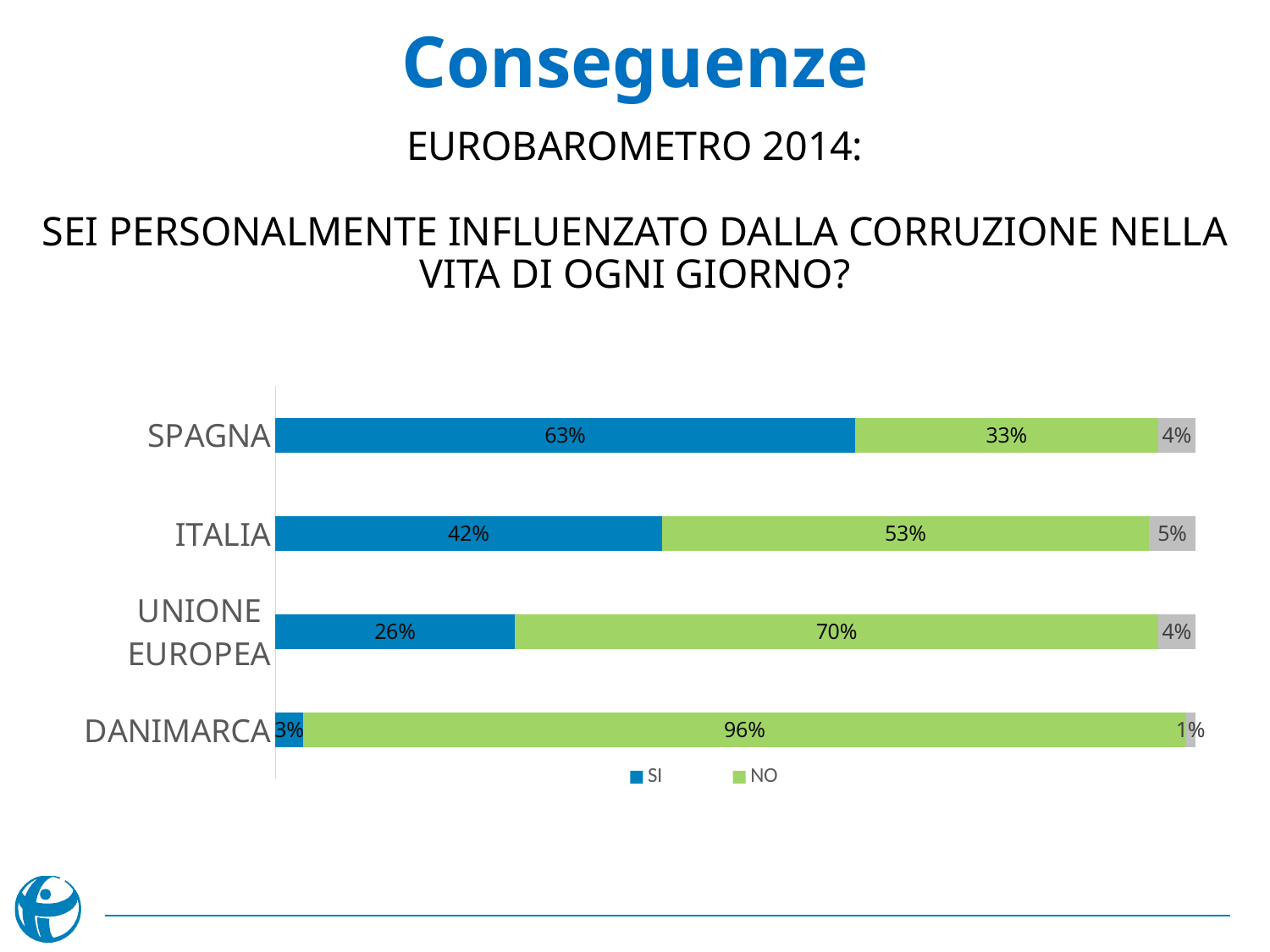
Which colour represents the NO series in the chart? Green How many categories are shown on the chart? 4 What is the SI value for UNIONE EUROPEA? 26% What percentage of respondents in ITALIA answered NO? 53% What is the difference between the NO value for DANIMARCA and the NO value for SPAGNA? 63% Which category has the highest SI value? SPAGNA Which category has the lowest SI value? DANIMARCA What kind of chart is shown on the slide? Stacked bar chart What is the NO value for DANIMARCA? 96% What percentage of respondents in SPAGNA answered SI? 63% How many series does the legend list? 2 Which is larger: the SI value for ITALIA or the SI value for UNIONE EUROPEA? ITALIA